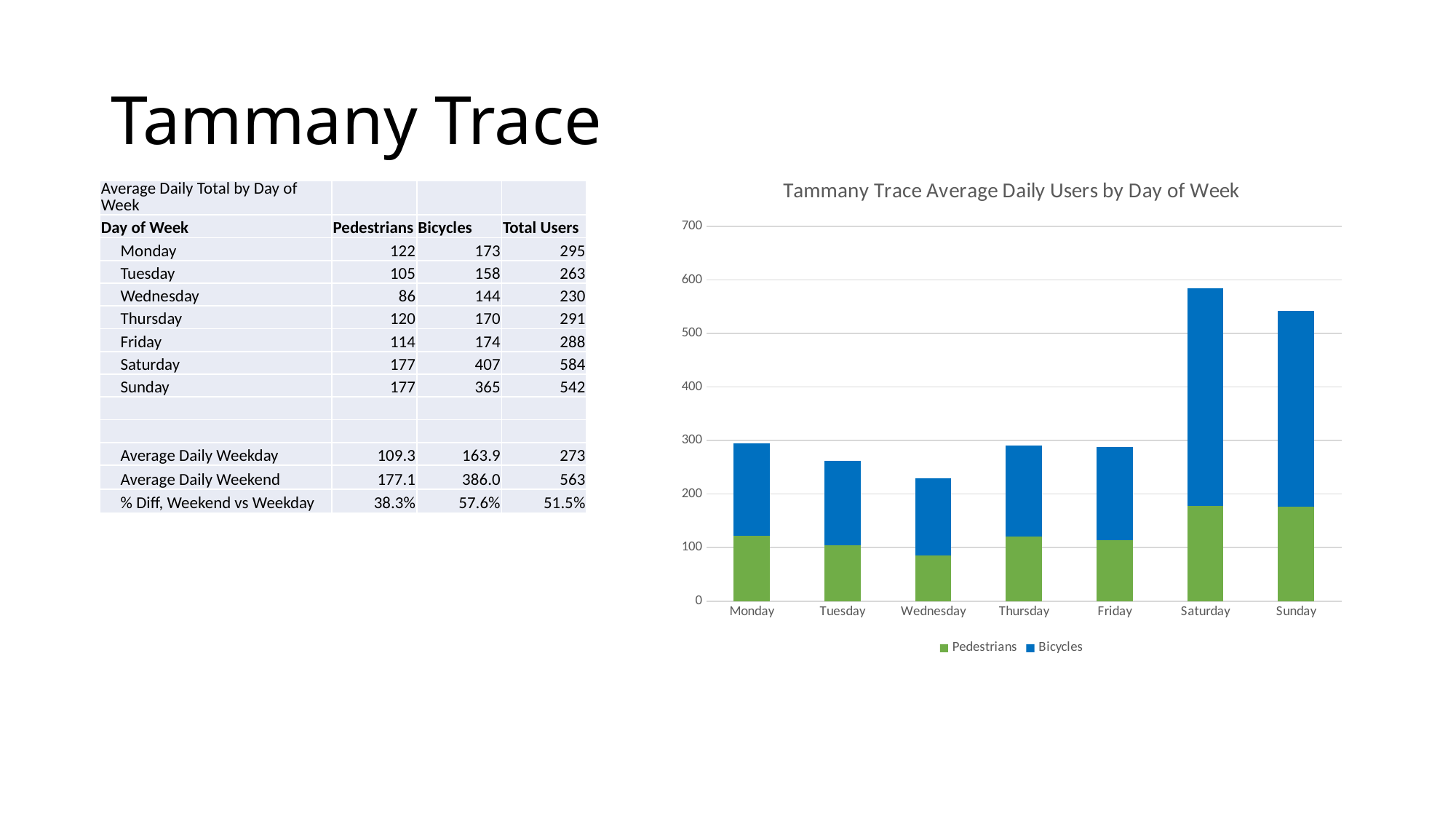
Is the total stacked bar for Saturday greater or less than 500? greater What is the title of the chart? Tammany Trace Average Daily Users by Day of Week Is the total stacked bar for Wednesday greater or less than 300? less Which colour represents Bicycles in the chart? blue Which is larger, the stacked bar for Saturday or the stacked bar for Sunday? Saturday Which day has the tallest stacked bar in the chart? Saturday Is the Pedestrians segment for Monday greater or less than 200? less What kind of chart is shown on the slide? stacked bar chart Which is larger, the stacked bar for Tuesday or the stacked bar for Thursday? Thursday How many days of the week are plotted on the x axis of the chart? 7 Which day has the shortest stacked bar in the chart? Wednesday How many series does the chart legend list? 2